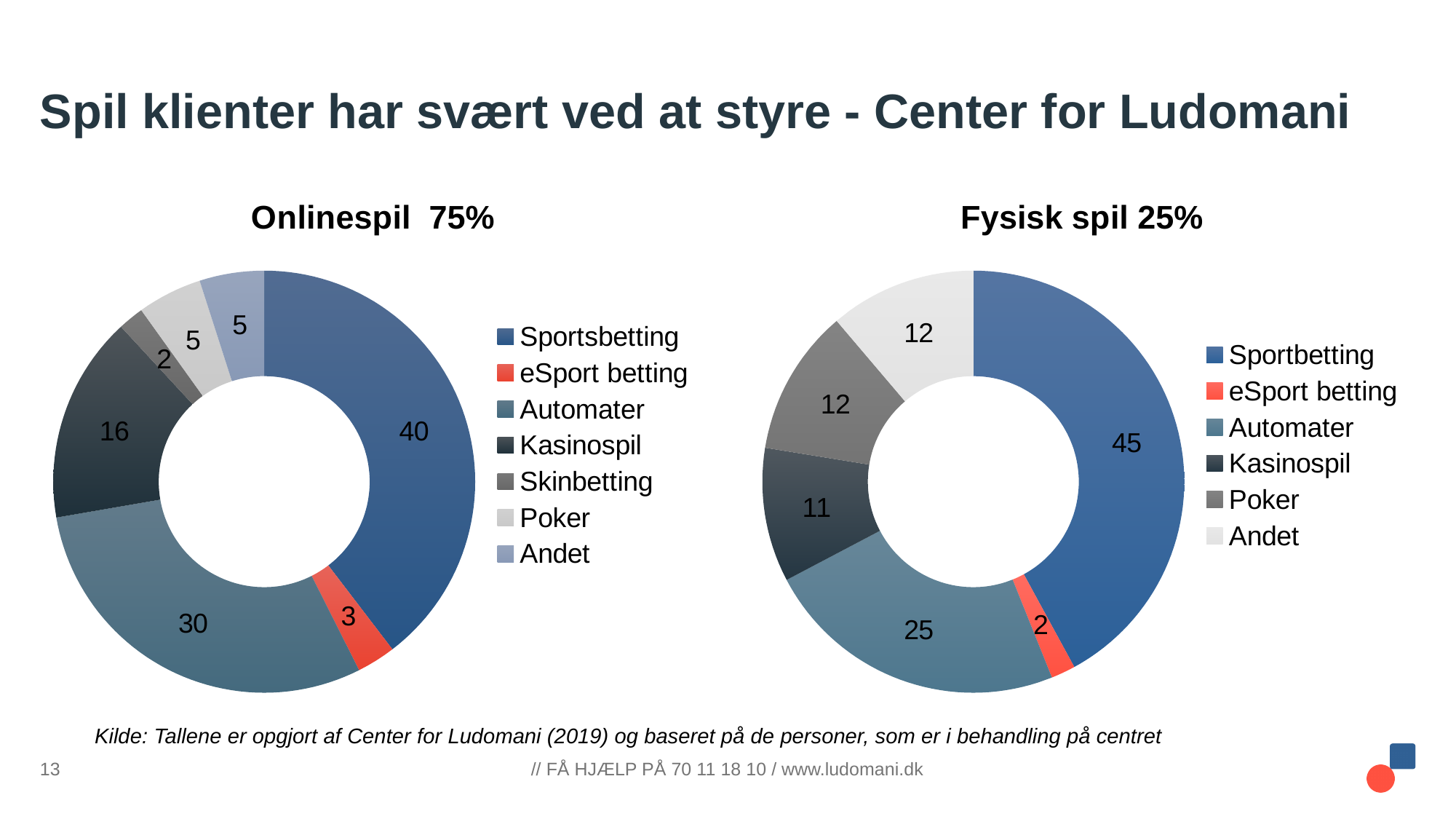
How many categories does the legend of the Onlinespil 75% chart list? 7 In the Fysisk spil 25% chart, what is the value for Automater? 25 In the Onlinespil 75% chart, what is the difference between Sportsbetting and Automater? 10 In the Fysisk spil 25% chart, what is the value for Kasinospil? 11 In the Onlinespil 75% chart, what is the value for Kasinospil? 16 What type of chart is the Fysisk spil 25% chart? Doughnut chart In the Fysisk spil 25% chart, what is the difference between Sportbetting and eSport betting? 43 In the Onlinespil 75% chart, which is larger, Kasinospil or Poker? Kasinospil How many categories does the legend of the Fysisk spil 25% chart list? 6 In the Fysisk spil 25% chart, which category has the largest value? Sportbetting In the Onlinespil 75% chart, what is the value for Sportsbetting? 40 In the Onlinespil 75% chart, which category has the smallest value? Skinbetting